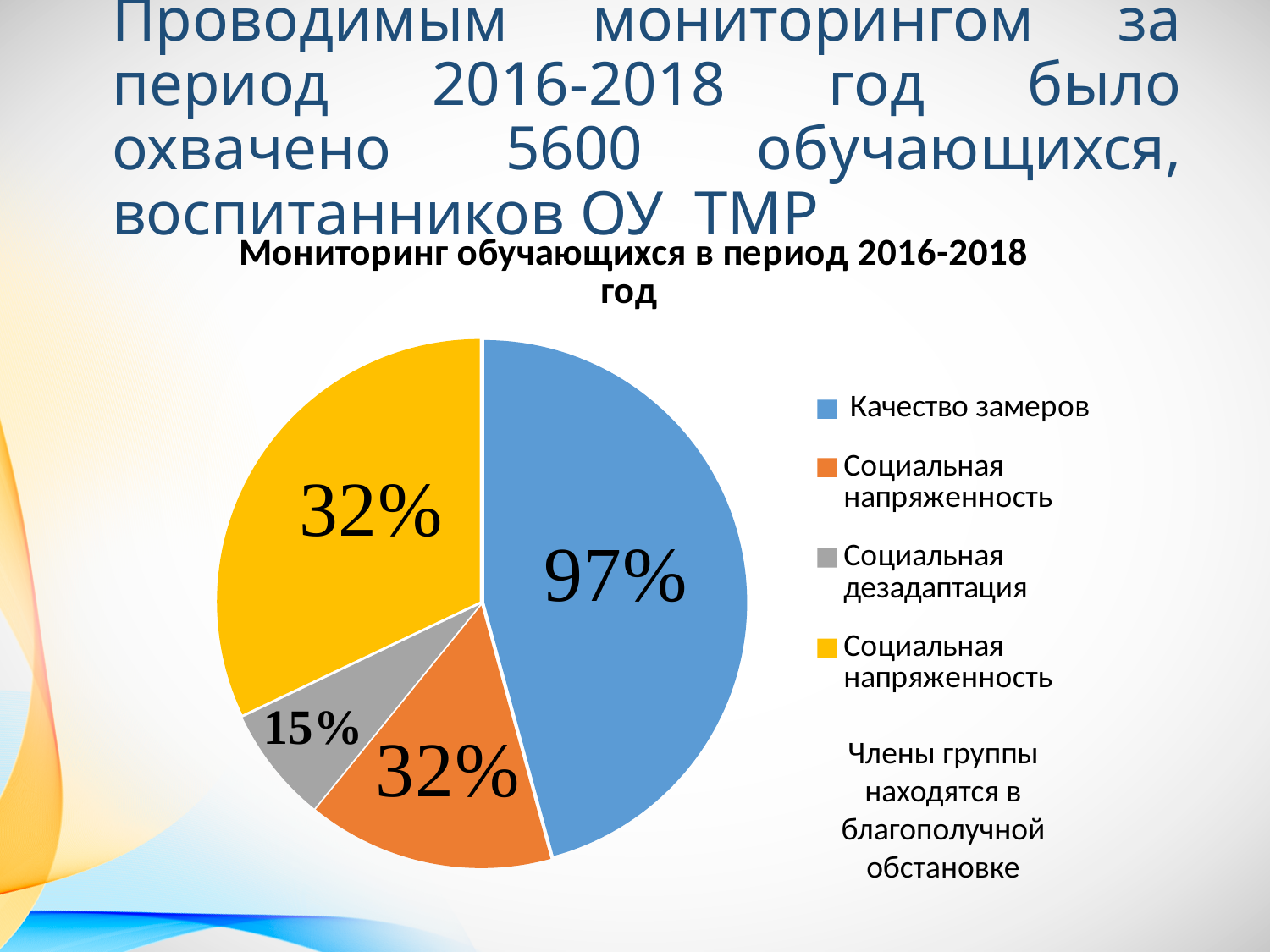
What colour represents Качество замеров in the chart? Blue How many entries does the legend list? 4 Which category has the smallest slice? Социальная дезадаптация What value is labelled on the orange slice? 32% What is the difference between the values for Качество замеров and Социальная дезадаптация? 82% What value is shown for Качество замеров? 97% Which category has the largest slice? Качество замеров What is the title of the chart? Мониторинг обучающихся в период 2016-2018 год What value is shown for Социальная дезадаптация? 15% What type of chart is shown on the slide? Pie chart How many slices does the pie chart have? 4 What value is labelled on the yellow slice? 32%